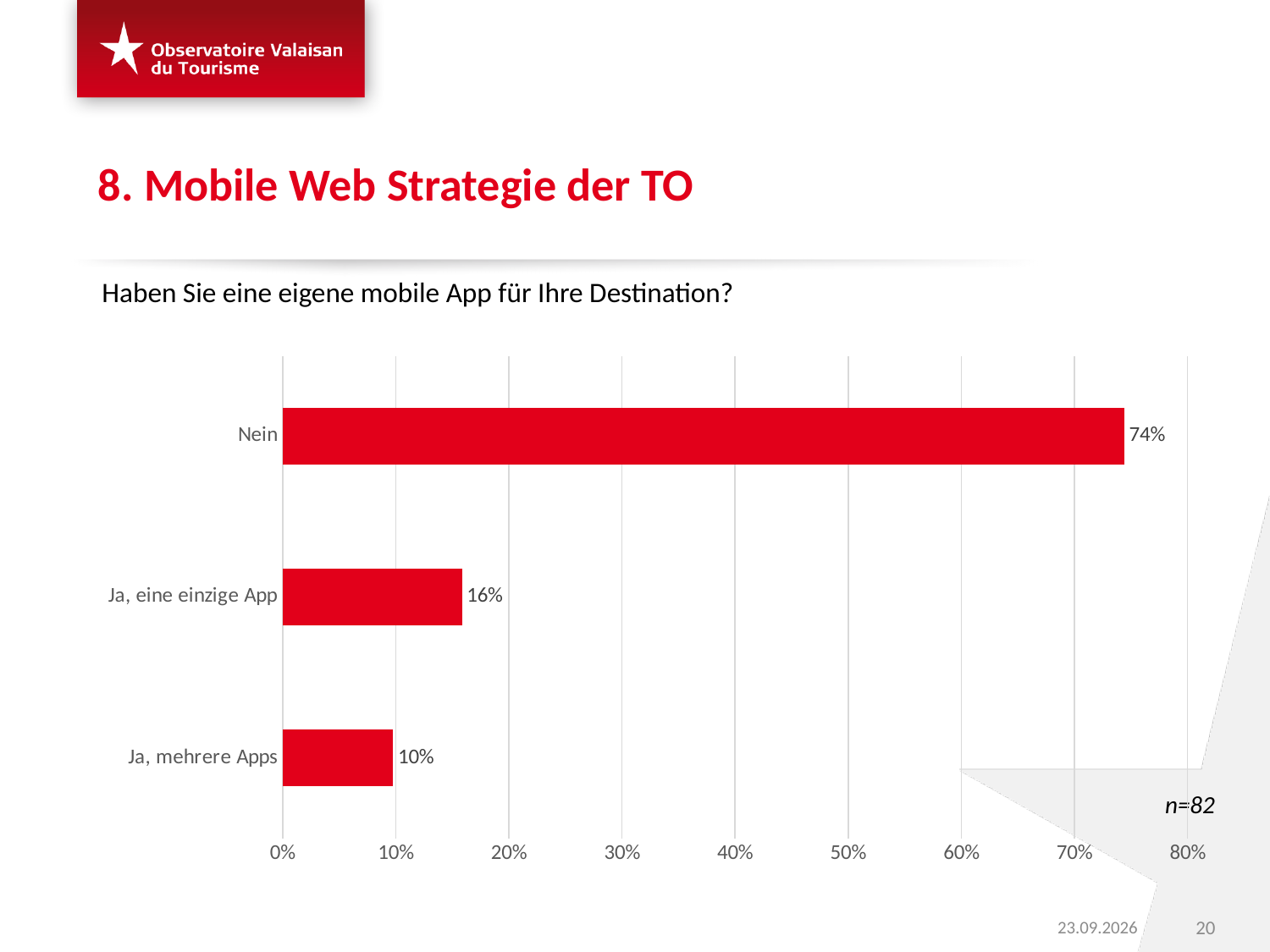
What is the difference between the values for "Nein" and "Ja, eine einzige App"? 58% Which is larger, the value for "Ja, eine einzige App" or the value for "Ja, mehrere Apps"? Ja, eine einzige App What sample size (n) is stated on the slide for the chart? n=82 What is the difference between the values for "Ja, eine einzige App" and "Ja, mehrere Apps"? 6% How many categories are shown in the chart? 3 What is the value for "Nein"? 74% What is the value for "Ja, eine einzige App"? 16% Is the value for "Nein" greater or less than 70%? greater Which category has the highest value? Nein What is the value for "Ja, mehrere Apps"? 10% What kind of chart is shown on the slide? bar chart Which category has the lowest value? Ja, mehrere Apps